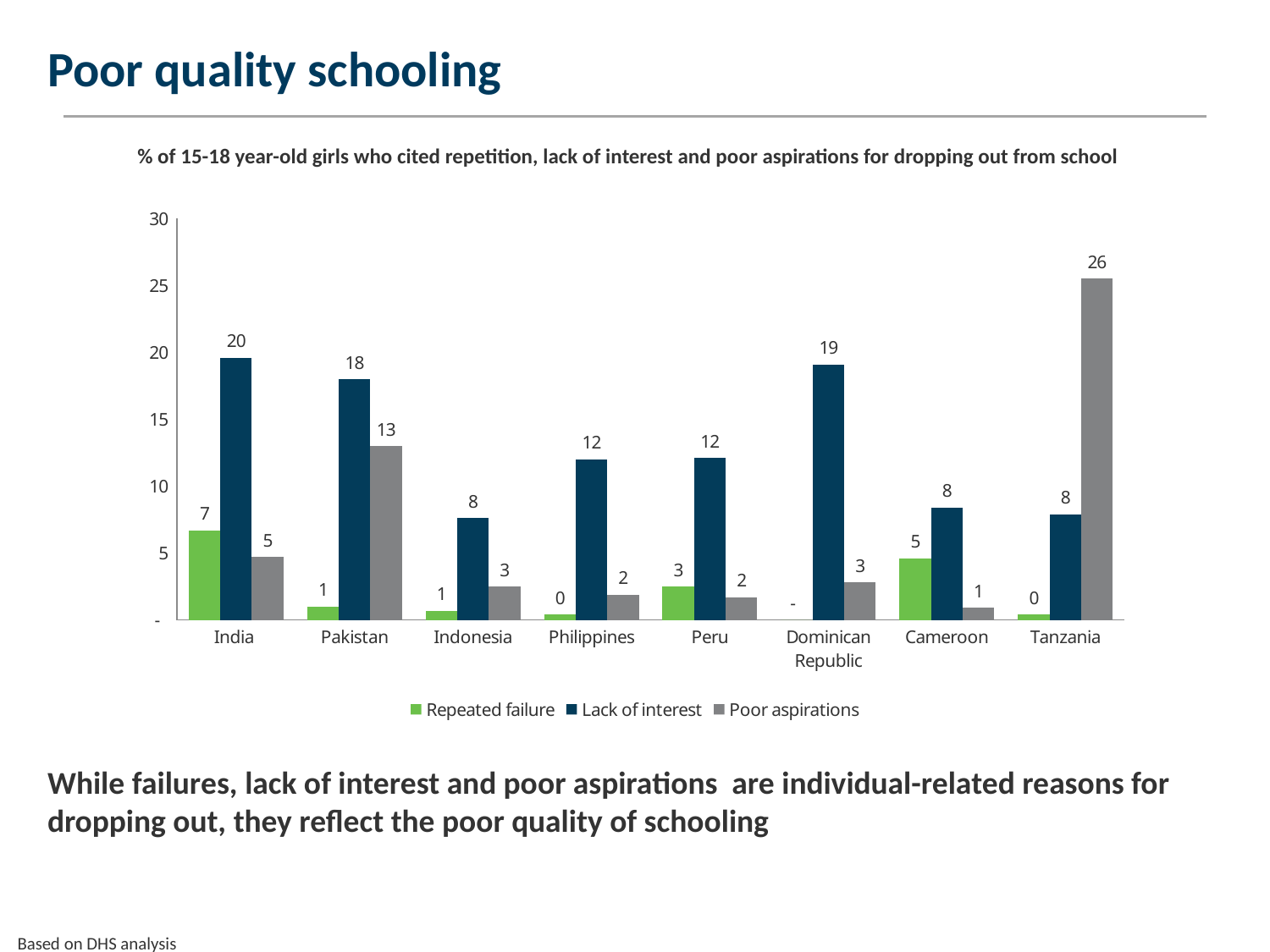
What is the difference between Lack of interest and Poor aspirations in Pakistan? 5 Which country has the highest value for Poor aspirations? Tanzania Which country has the highest value for Lack of interest? India What is the value for Poor aspirations in Tanzania? 26 How many countries are shown on the x axis? 8 How many series does the legend list? 3 Which country has the highest value for Repeated failure? India What kind of chart is shown on the slide? Bar chart What is the value for Lack of interest in India? 20 Which series is shown in green in the legend? Repeated failure What is the value for Repeated failure in Cameroon? 5 Which is larger in the Dominican Republic: Lack of interest or Poor aspirations? Lack of interest